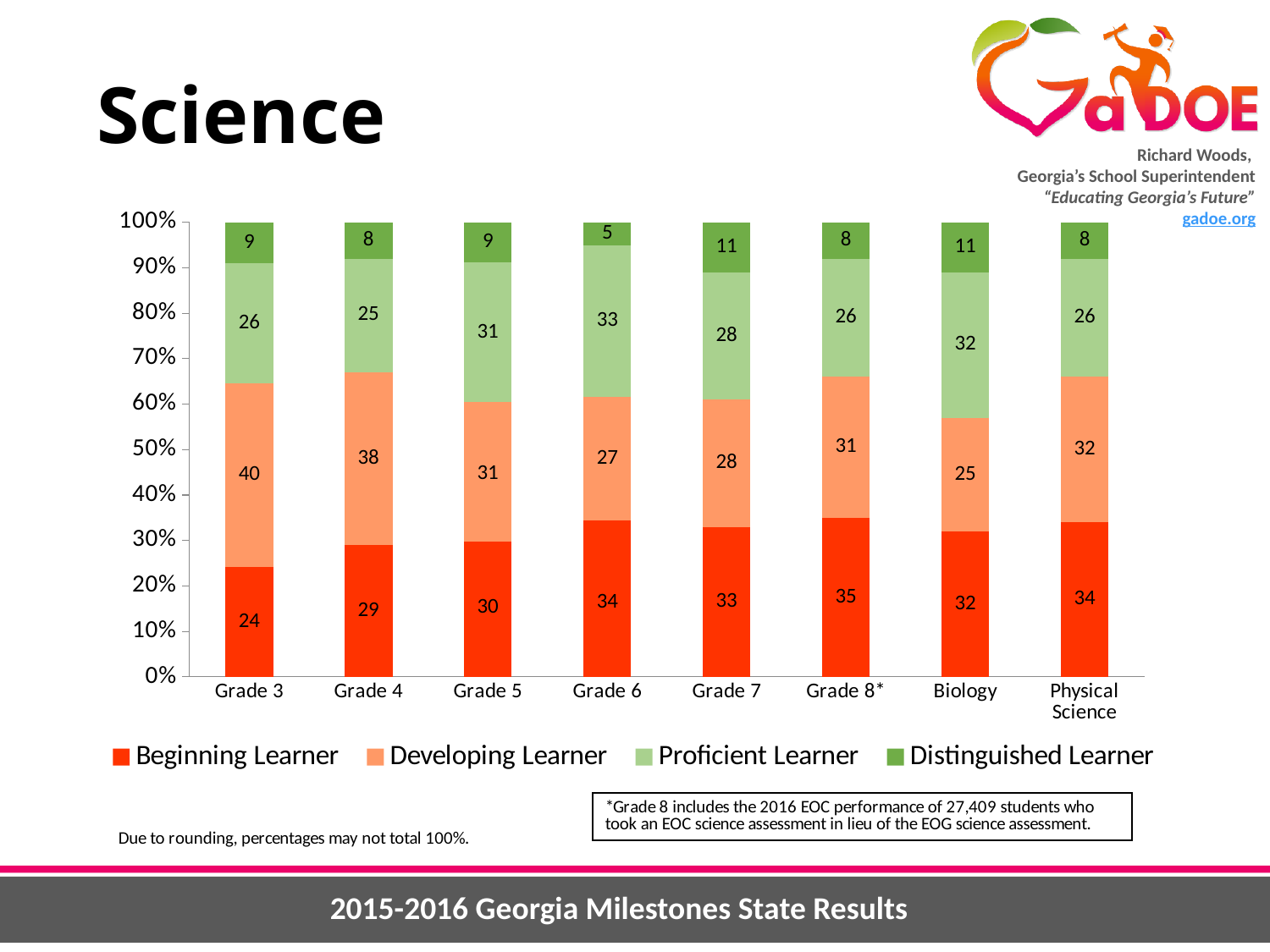
Which is larger, the Proficient Learner value for Grade 6 or for Grade 7? Grade 6 What is the Developing Learner value for Grade 4? 38 What is the Beginning Learner value for Grade 3? 24 Which category has the lowest Distinguished Learner value? Grade 6 How many categories are shown on the x axis? 8 What is the difference between the Developing Learner values for Grade 3 and Biology? 15 How many series does the legend list? 4 What is the Proficient Learner value for Biology? 32 Which legend entry is shown in the darkest green colour? Distinguished Learner What kind of chart is shown on the slide? Stacked bar chart Which category has the highest Beginning Learner value? Grade 8* What is the Distinguished Learner value for Grade 6? 5